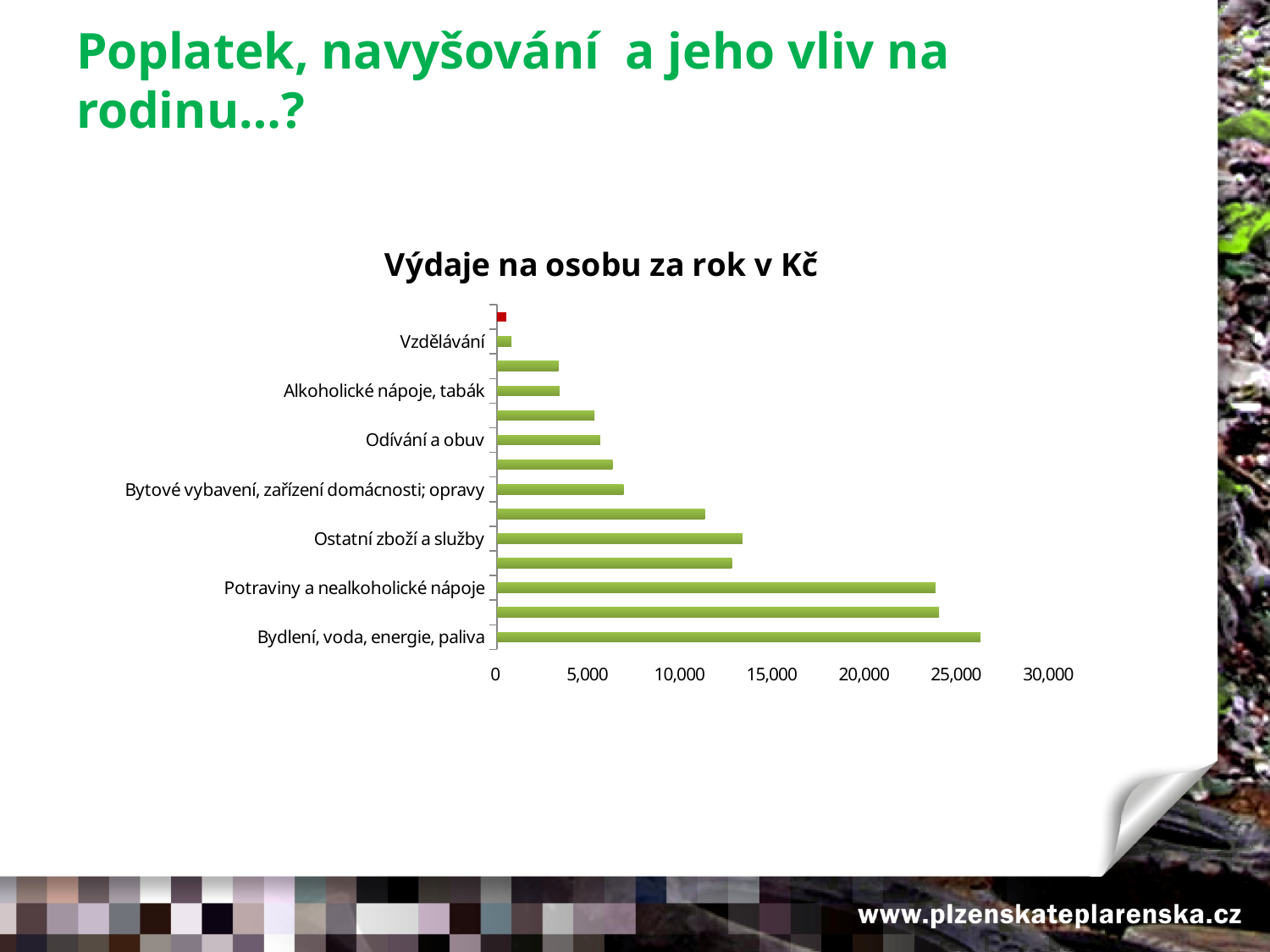
What kind of chart is shown on the slide? bar chart What is the title of the chart? Výdaje na osobu za rok v Kč Is the value for Potraviny a nealkoholické nápoje greater or less than 25,000? less Which is larger, the value for Bydlení, voda, energie, paliva or the value for Potraviny a nealkoholické nápoje? Bydlení, voda, energie, paliva What is the highest value shown on the horizontal axis? 30,000 Is the value for Bytové vybavení, zařízení domácnosti; opravy greater or less than 10,000? less Which labelled category has the highest value? Bydlení, voda, energie, paliva Is the value for Ostatní zboží a služby greater or less than 10,000? greater Which labelled category has the lowest value? Vzdělávání Which is larger, the value for Ostatní zboží a služby or the value for Odívání a obuv? Ostatní zboží a služby